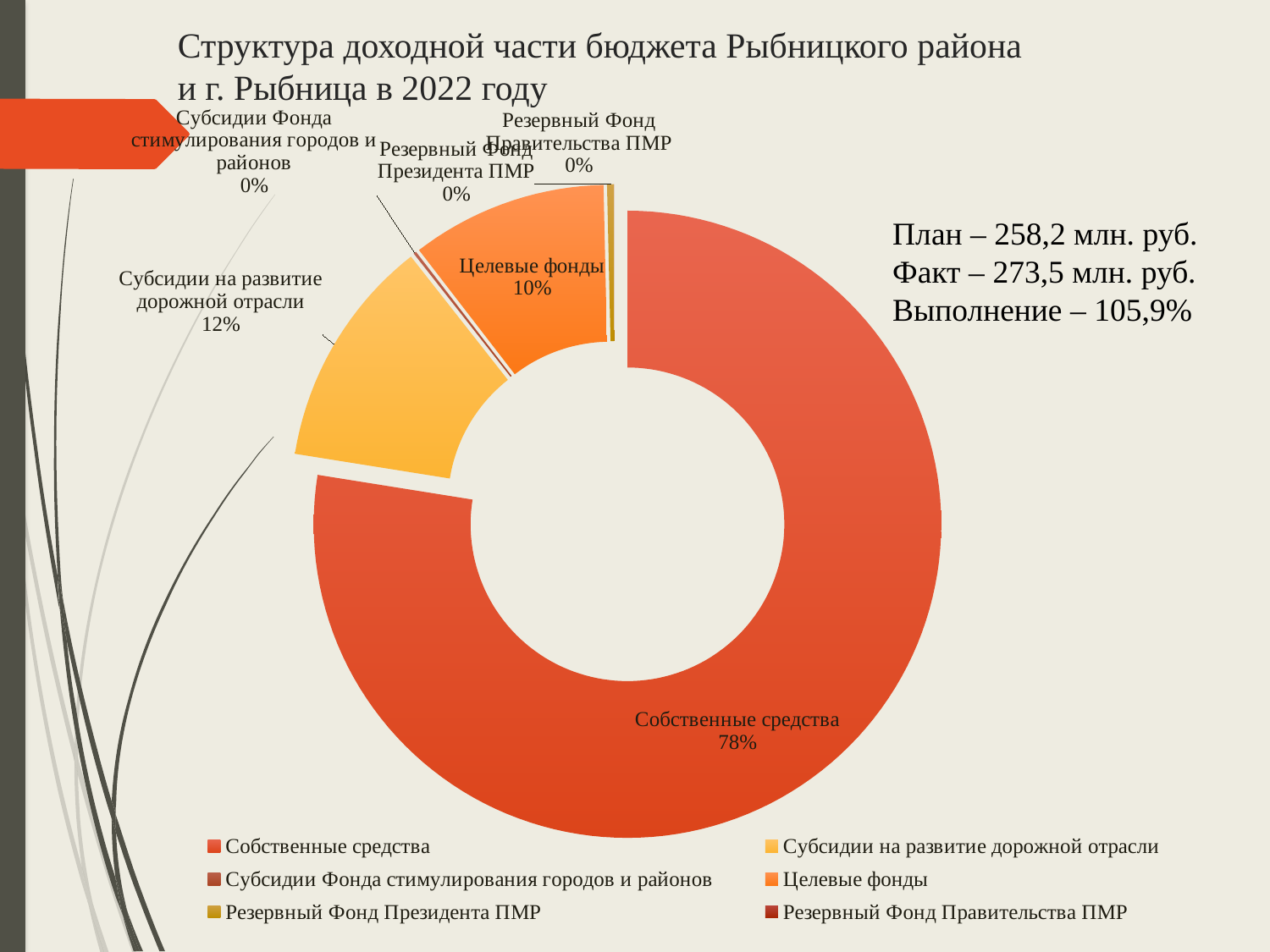
How many categories does the legend list? 6 Which category has the largest share of the chart? Собственные средства What is the title of the chart? Структура доходной части бюджета Рыбницкого района и г. Рыбница в 2022 году What kind of chart is shown on the slide? Doughnut (pie) chart What share of the chart does Собственные средства account for? 78% What share of the chart does Субсидии на развитие дорожной отрасли account for? 12% What is the difference in percentage points between Субсидии на развитие дорожной отрасли and Целевые фонды? 2 What colour is the Собственные средства slice? Red Which is larger: Субсидии на развитие дорожной отрасли or Целевые фонды? Субсидии на развитие дорожной отрасли What is the difference in percentage points between Собственные средства and Субсидии на развитие дорожной отрасли? 66 What share of the chart does Целевые фонды account for? 10% What share is shown for Резервный Фонд Президента ПМР? 0%